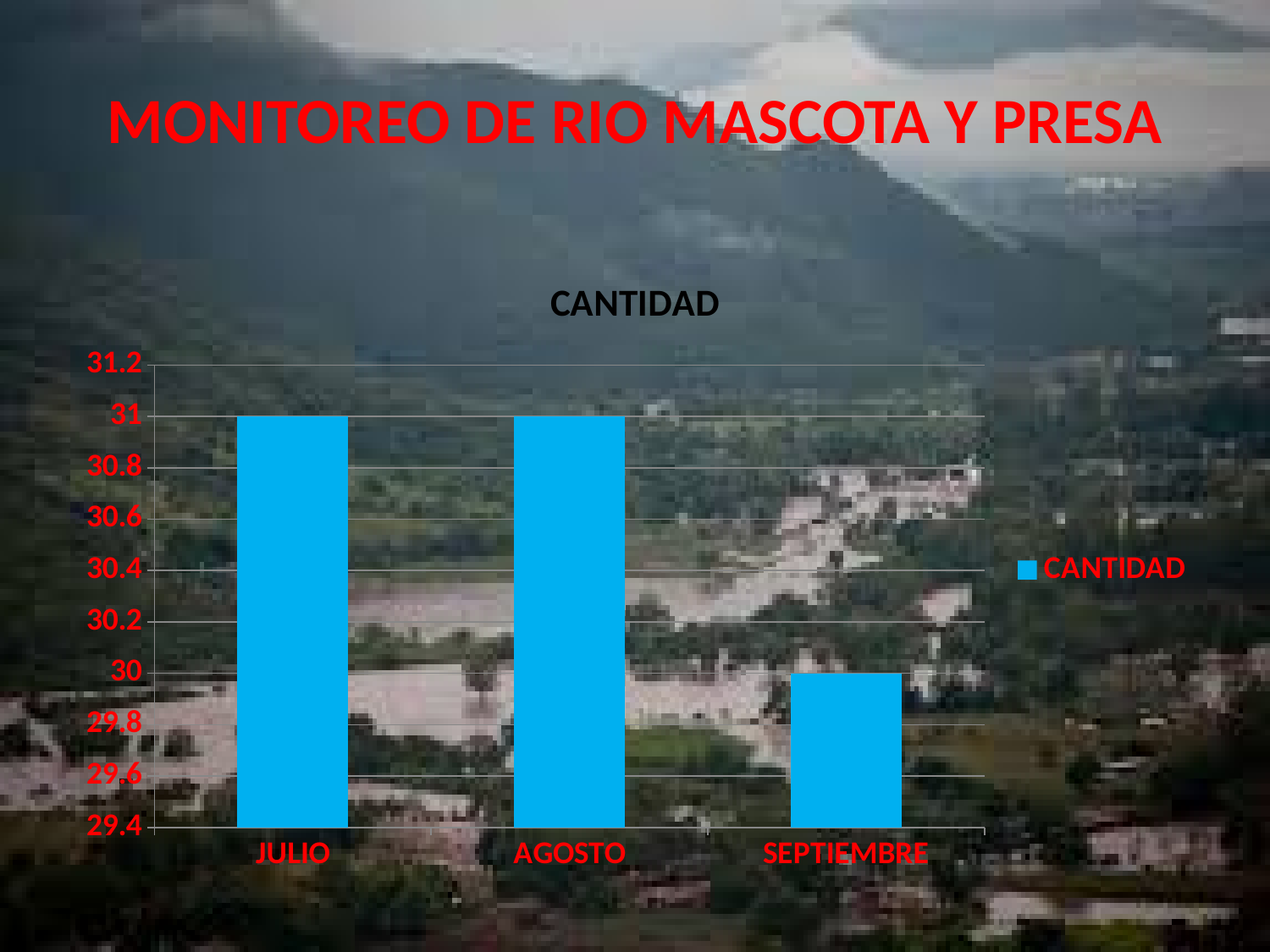
How many months are shown on the x axis? 3 What kind of chart is shown on the slide? bar chart What is the difference between the values for JULIO and SEPTIEMBRE? 1 Which month has the lowest value? SEPTIEMBRE What is the value for SEPTIEMBRE? 30 Which is larger, the value for AGOSTO or the value for SEPTIEMBRE? AGOSTO Do the values rise or fall from JULIO to SEPTIEMBRE? fall What is the value for JULIO? 31 Is the value for SEPTIEMBRE greater or less than 30.4? less What is the value for AGOSTO? 31 What is the title of the chart? CANTIDAD How many series does the legend list? 1